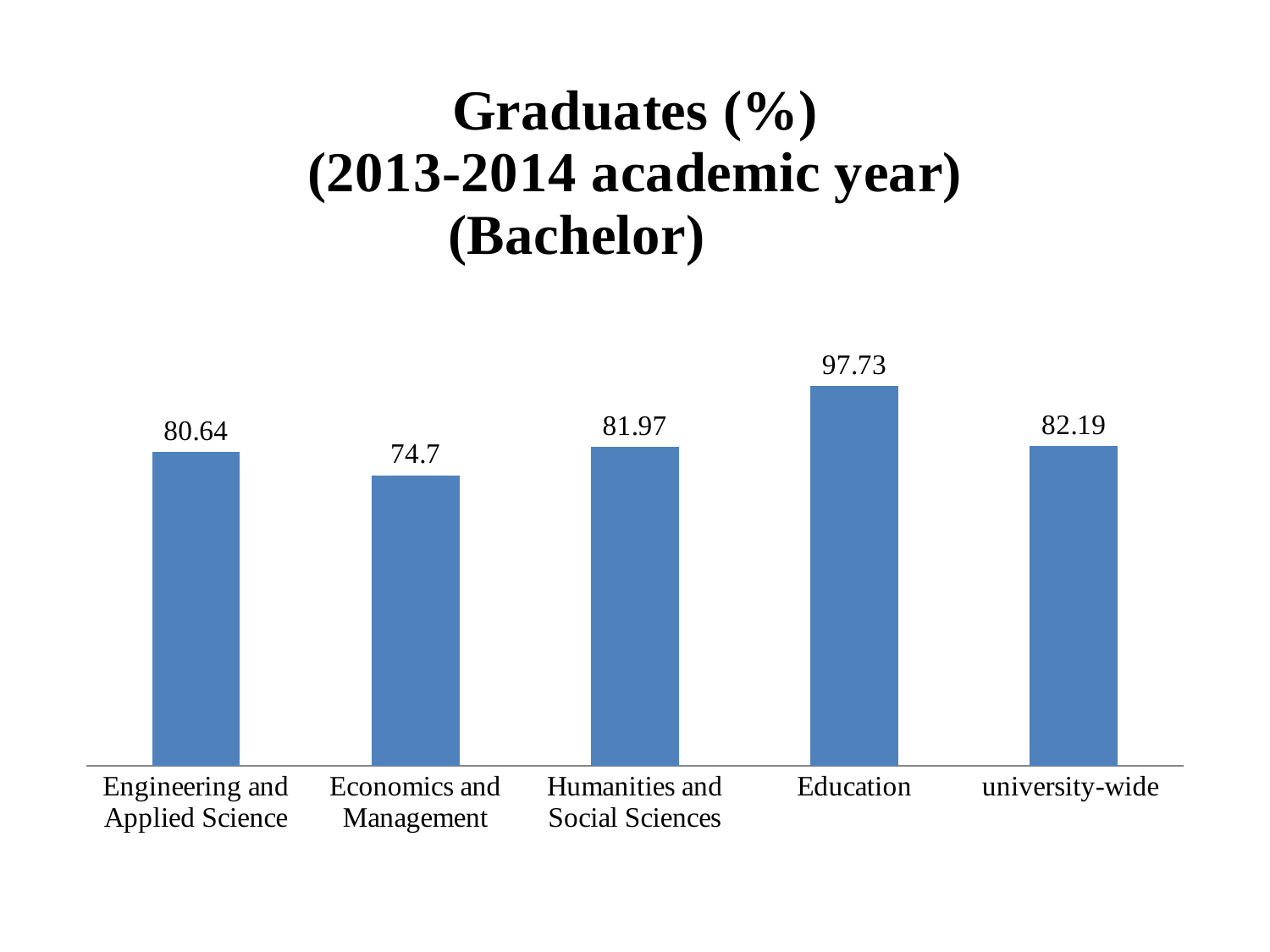
What kind of chart is shown on the slide? Bar chart How many categories are shown in the chart? 5 What is the value for Economics and Management? 74.7 What is the value for Engineering and Applied Science? 80.64 What is the value for Education? 97.73 Which is larger, the value for Humanities and Social Sciences or the value for Engineering and Applied Science? Humanities and Social Sciences Which category has the lowest value? Economics and Management What is the difference between the values for Education and Economics and Management? 23.03 Which category has the highest value? Education What is the university-wide value? 82.19 What is the title of the chart? Graduates (%) (2013-2014 academic year) (Bachelor) What is the difference between the values for Humanities and Social Sciences and Engineering and Applied Science? 1.33